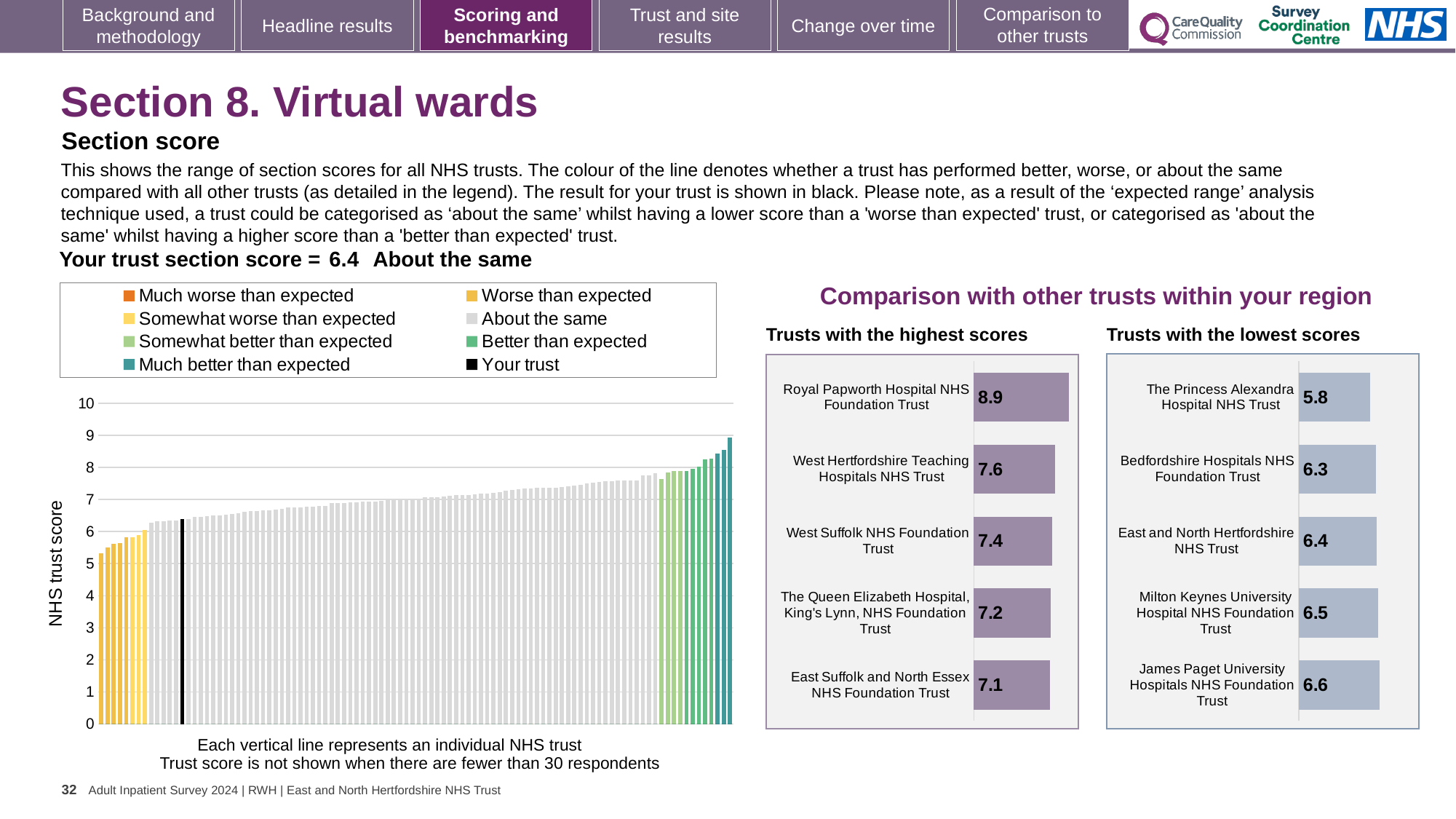
In the 'Trusts with the lowest scores' chart, what is the score for The Princess Alexandra Hospital NHS Trust? 5.8 What kind of chart is the large 'NHS trust score' chart on the left of the slide? Bar chart How many entries does the legend of the large 'NHS trust score' chart on the left list? 8 In the large 'NHS trust score' chart on the left, do the bars rise or fall from left to right? Rise In the 'Trusts with the lowest scores' chart, which trust has the lowest score? The Princess Alexandra Hospital NHS Trust In the 'Trusts with the highest scores' chart, what is the difference between the scores of Royal Papworth Hospital NHS Foundation Trust and East Suffolk and North Essex NHS Foundation Trust? 1.8 In the 'Trusts with the highest scores' chart, which trust has the highest score? Royal Papworth Hospital NHS Foundation Trust In the 'Trusts with the lowest scores' chart, which has the larger score: Bedfordshire Hospitals NHS Foundation Trust or Milton Keynes University Hospital NHS Foundation Trust? Milton Keynes University Hospital NHS Foundation Trust How many trusts are listed in the 'Trusts with the lowest scores' chart? 5 In the large 'NHS trust score' chart on the left, is the value of the tallest bar greater or less than 8? greater In the 'Trusts with the highest scores' chart, what is the score for West Suffolk NHS Foundation Trust? 7.4 In the 'Trusts with the highest scores' chart, what is the score for Royal Papworth Hospital NHS Foundation Trust? 8.9